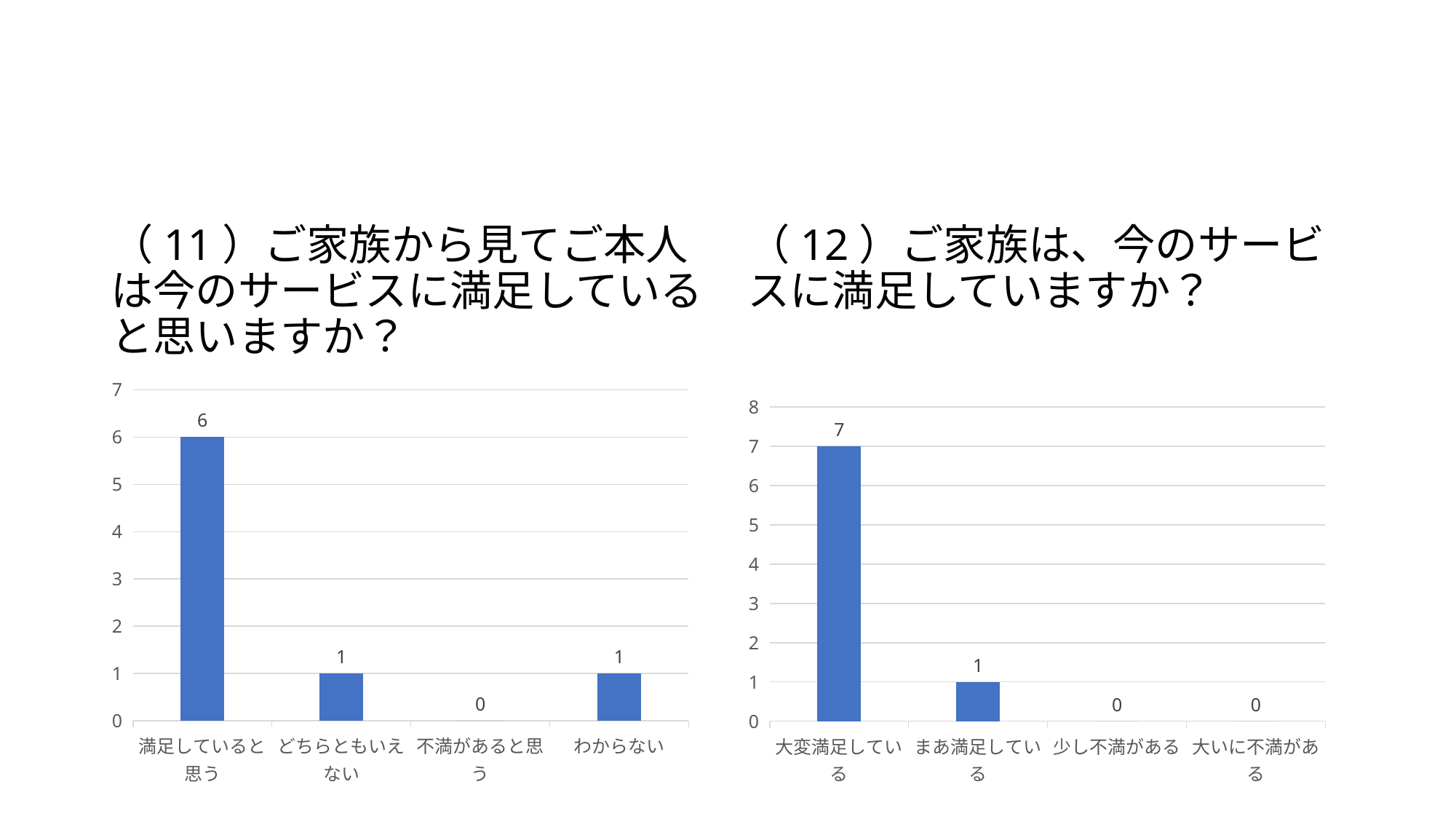
In the right chart (12), which is larger, 少し不満がある or まあ満足している? まあ満足している In the right chart (12), do the values rise or fall from left to right along the x axis? Fall In the right chart (12), what is the difference between 大変満足している and まあ満足している? 6 In the left chart (11), what is the value for 不満があると思う? 0 In the left chart (11), which category has the highest value? 満足していると思う In the left chart (11), how many categories are shown on the x axis? 4 What kind of chart is the right chart (12)? Bar chart In the left chart (11), what is the value for 満足していると思う? 6 In the right chart (12), which category has the highest value? 大変満足している In the right chart (12), what is the value for 大変満足している? 7 In the right chart (12), what is the value for まあ満足している? 1 In the left chart (11), what is the difference between 満足していると思う and わからない? 5